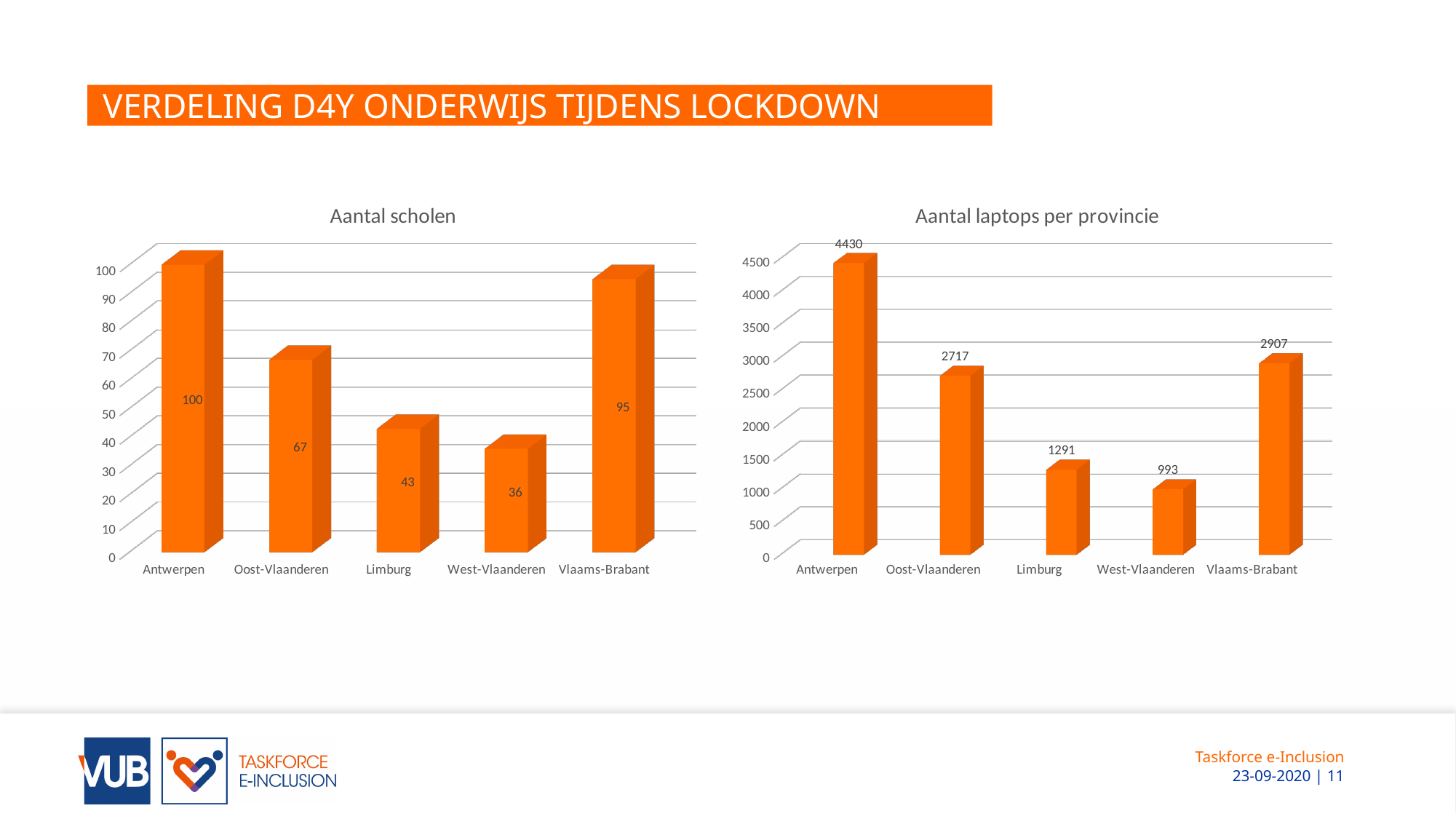
How many provinces are shown in the 'Aantal laptops per provincie' chart? 5 In the 'Aantal laptops per provincie' chart, which province has the lowest value? West-Vlaanderen In the 'Aantal laptops per provincie' chart, what is the value for Oost-Vlaanderen? 2717 In the 'Aantal laptops per provincie' chart, which is larger: Limburg or West-Vlaanderen? Limburg In the 'Aantal scholen' chart, which province has the highest value? Antwerpen What kind of chart is the 'Aantal scholen' chart? bar chart In the 'Aantal laptops per provincie' chart, what is the difference between Antwerpen and Vlaams-Brabant? 1523 In the 'Aantal scholen' chart, what is the difference between Antwerpen and Vlaams-Brabant? 5 What is the title of the chart on the right side of the slide? Aantal laptops per provincie In the 'Aantal scholen' chart, what is the value for Limburg? 43 In the 'Aantal scholen' chart, what is the value for West-Vlaanderen? 36 In the 'Aantal scholen' chart, is the value for Oost-Vlaanderen greater or less than 60? greater